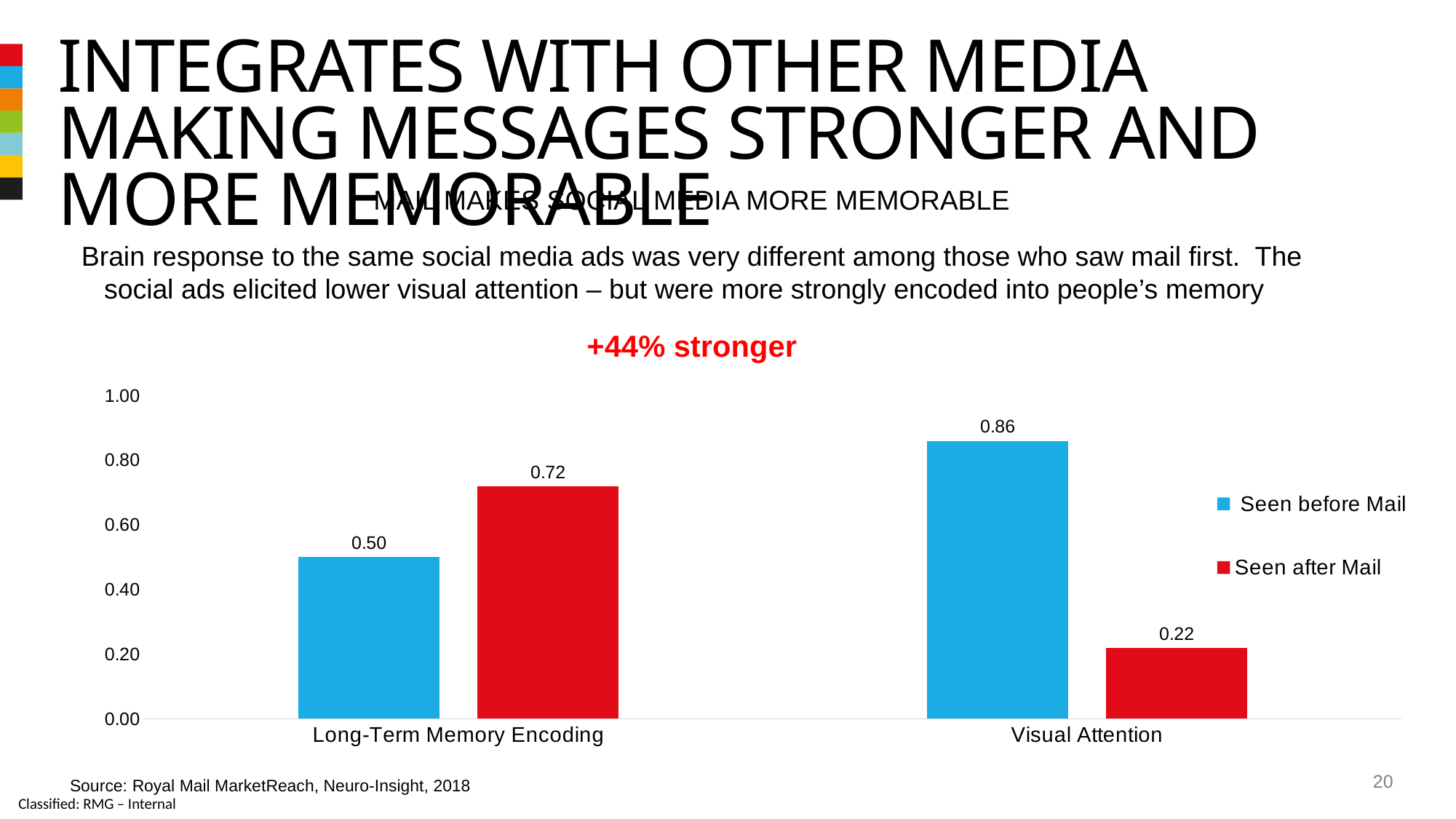
What is the value for Seen after Mail in the Visual Attention category? 0.22 How many series does the legend list? 2 What kind of chart is shown on the slide? Bar chart What is the difference between Seen before Mail and Seen after Mail for Visual Attention? 0.64 What is the value for Seen before Mail in the Visual Attention category? 0.86 Which bar has the lowest value on the chart? Seen after Mail, Visual Attention For Long-Term Memory Encoding, which is larger: Seen before Mail or Seen after Mail? Seen after Mail What is the value for Seen after Mail in the Long-Term Memory Encoding category? 0.72 Which bar has the highest value on the chart? Seen before Mail, Visual Attention What is the difference between Seen after Mail and Seen before Mail for Long-Term Memory Encoding? 0.22 What is the value for Seen before Mail in the Long-Term Memory Encoding category? 0.50 How many categories are shown on the x axis of the chart? 2